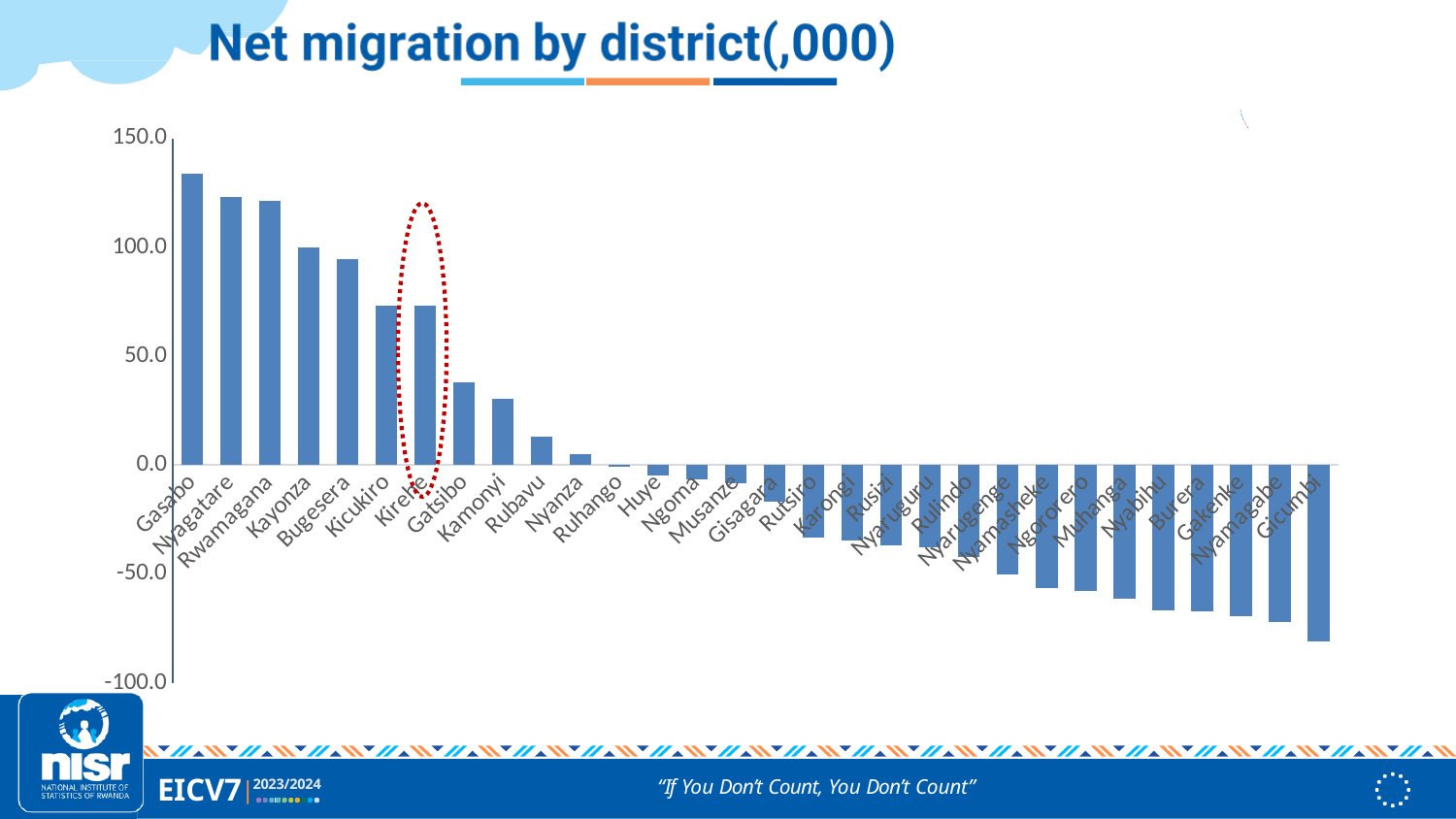
Is the value for Kicukiro greater or less than 50.0? greater How many districts are shown on the x axis of the chart? 30 Is the value for Burera greater or less than -50.0? less Is the value for Bugesera greater or less than 100.0? less Which district has a larger net migration, Gasabo or Nyagatare? Gasabo Which district has the highest net migration? Gasabo What type of chart is shown on the slide? Bar chart What is the title of the chart? Net migration by district(,000) Which district has the lowest net migration? Gicumbi Do the values rise or fall moving from left to right along the x axis? Fall